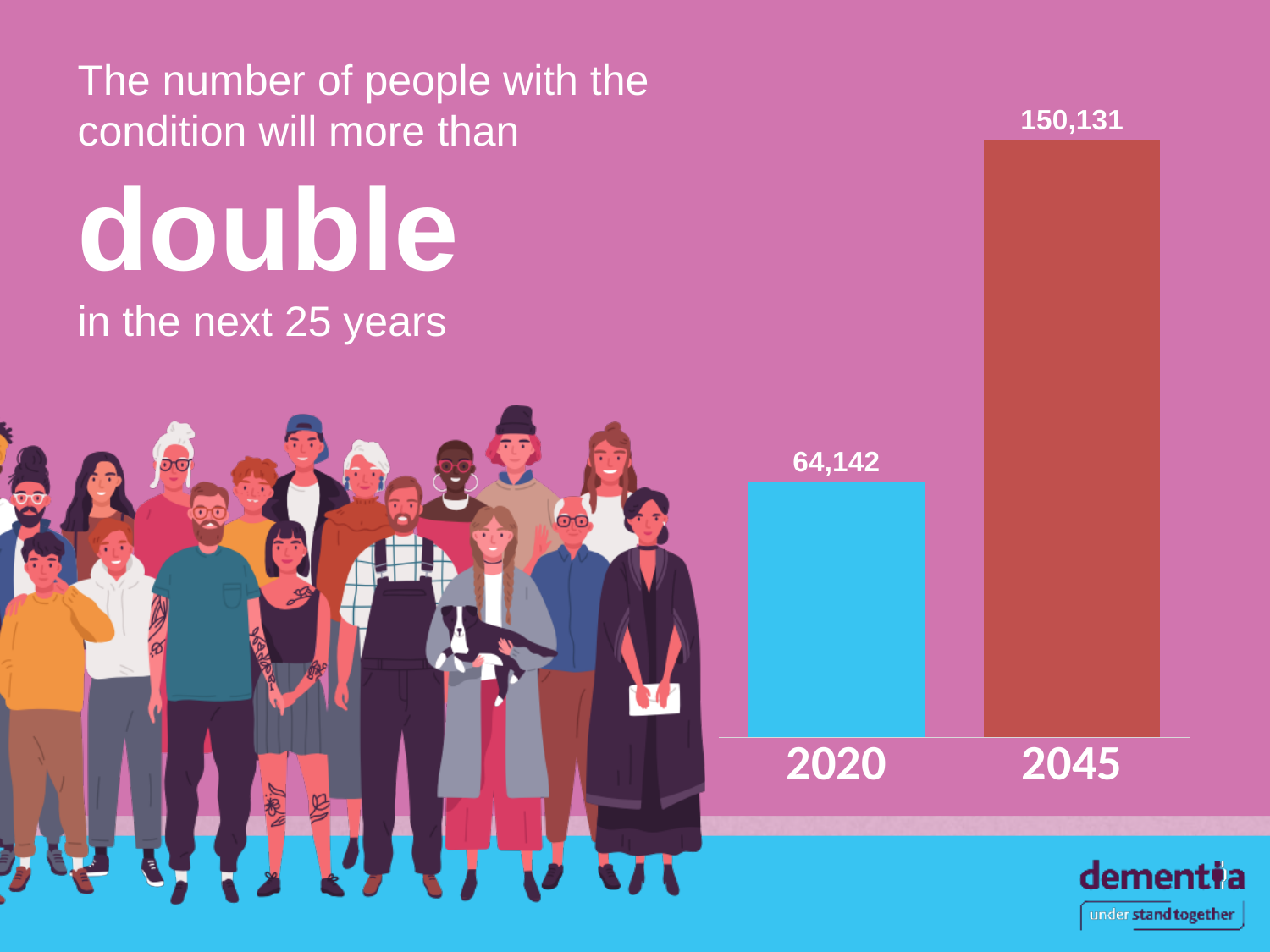
What is the difference between the 2045 value and the 2020 value? 85,989 What is the value shown for 2020? 64,142 What kind of chart is shown on the slide? bar chart Which year has the lower value? 2020 What is the value shown for 2045? 150,131 How many bars are shown in the chart? 2 Do the values rise or fall from 2020 to 2045? rise What colour is the bar for 2020? blue Which year has the higher value? 2045 Is the value for 2045 larger or smaller than the value for 2020? larger What colour is the bar for 2045? red